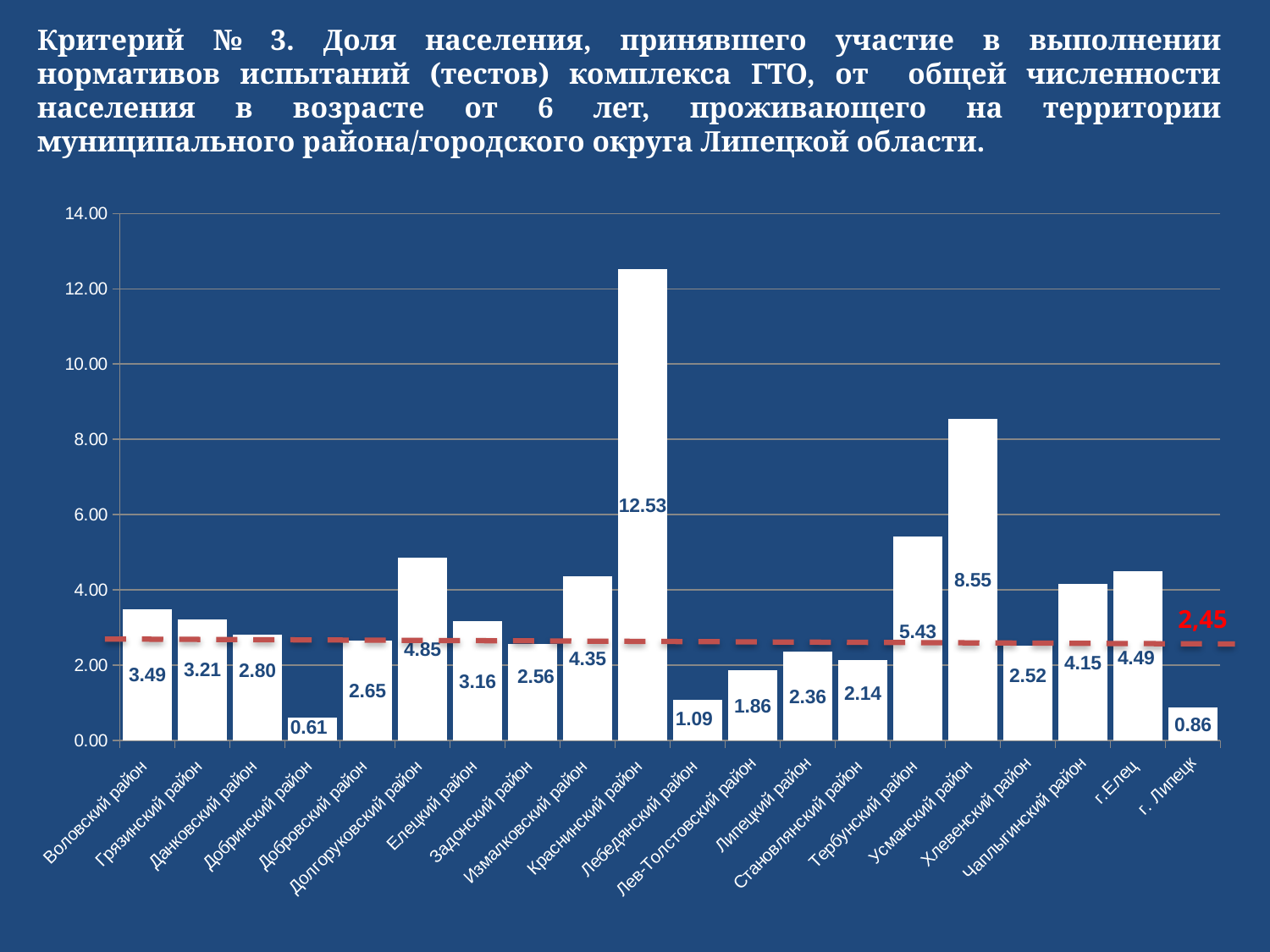
Is the value for Чаплыгинский район greater or less than 4.00? greater Which category has the lowest value? Добринский район What value is labelled on the red dashed horizontal line? 2,45 What is the difference between the values for Краснинский район and Усманский район? 3.98 What kind of chart is shown on the slide? bar chart Which is larger, the value for Тербунский район or the value for Долгоруковский район? Тербунский район What is the difference between the values for г.Елец and Чаплыгинский район? 0.34 What is the value for Краснинский район? 12.53 What is the value for Усманский район? 8.55 How many categories are shown on the x axis? 20 What is the value for г. Липецк? 0.86 Which category has the highest value? Краснинский район